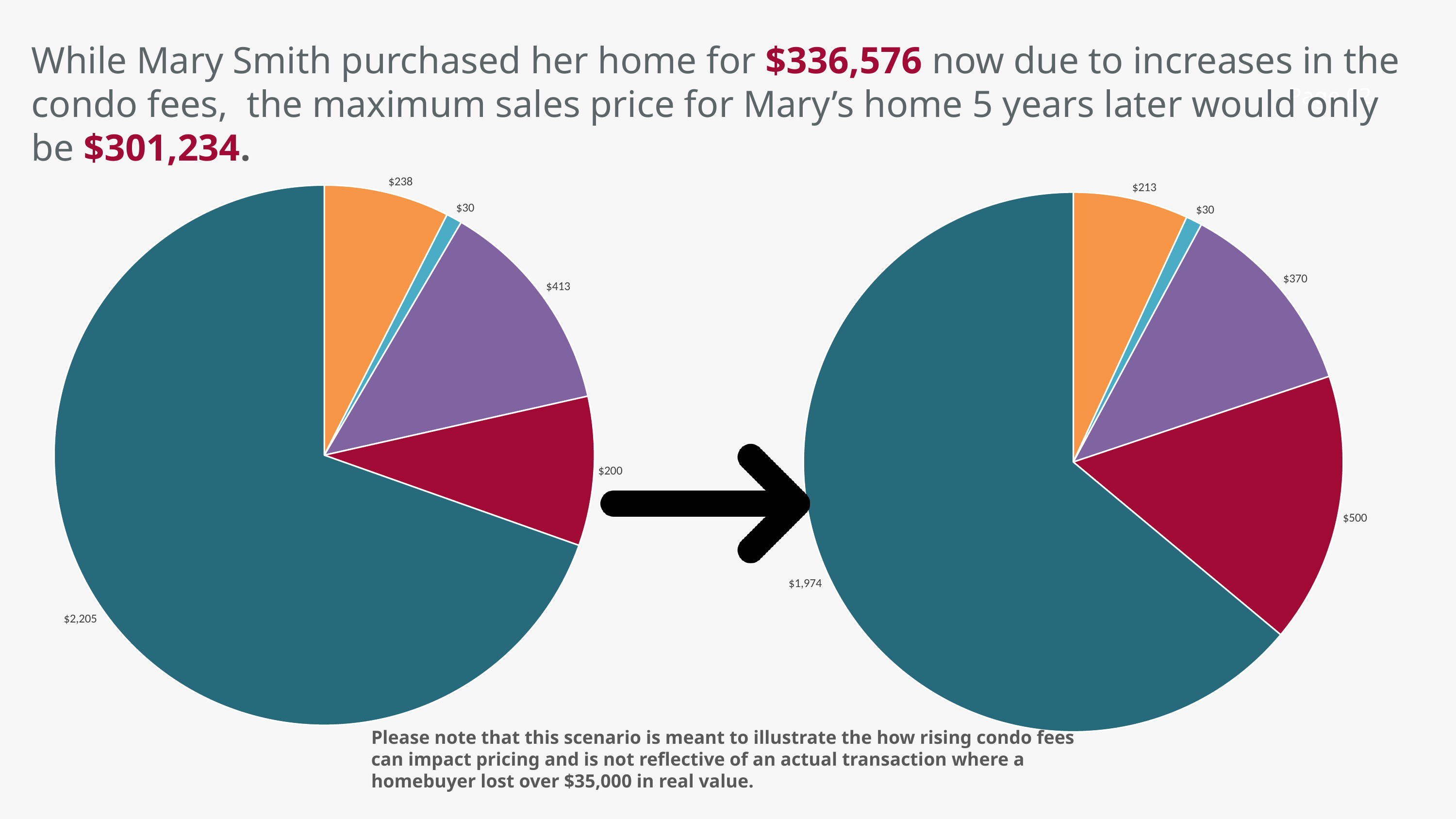
What is the difference between the red slice in the right pie chart ($500) and the red slice in the left pie chart ($200)? $300 In the left pie chart, which slice has the smallest value? The light blue slice ($30) In the left pie chart, what is the value of the orange slice? $238 In the right pie chart, what is the value of the red slice? $500 How many slices does the left pie chart have? 5 In the right pie chart, what is the value of the large teal slice? $1,974 Which is larger: the purple slice in the left pie chart or the purple slice in the right pie chart? The purple slice in the left pie chart ($413) In the right pie chart, which slice has the largest value? The teal slice ($1,974) What type of charts are shown on the slide? Pie charts How many slices does the right pie chart have? 5 In the left pie chart, what is the value of the large teal slice? $2,205 In the left pie chart, what is the value of the purple slice? $413